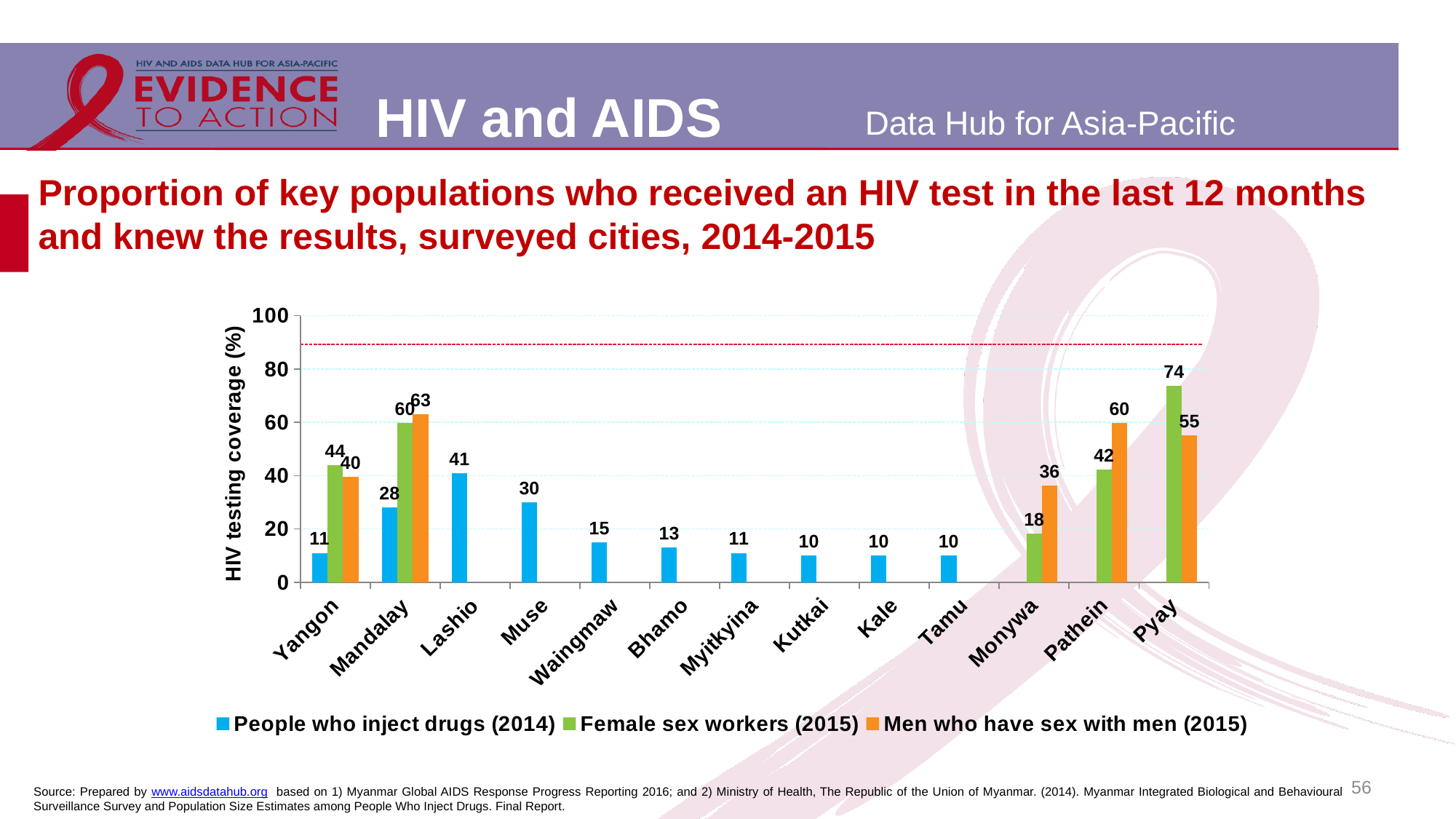
What is the HIV testing coverage for female sex workers (2015) in Pyay? 74 Which colour represents people who inject drugs (2014) in the chart? Blue What is the difference between the men who have sex with men (2015) value and the female sex workers (2015) value in Monywa? 18 What is the HIV testing coverage for men who have sex with men (2015) in Mandalay? 63 What is the label of the y axis? HIV testing coverage (%) Which city has the lowest HIV testing coverage for female sex workers (2015)? Monywa Which city has the highest HIV testing coverage for people who inject drugs (2014)? Lashio In Pyay, which is higher: the female sex workers (2015) value or the men who have sex with men (2015) value? Female sex workers (2015) How many cities are shown on the x axis of the chart? 13 How many series does the legend list? 3 What kind of chart is shown on the slide? Bar chart What is the HIV testing coverage for people who inject drugs (2014) in Lashio? 41